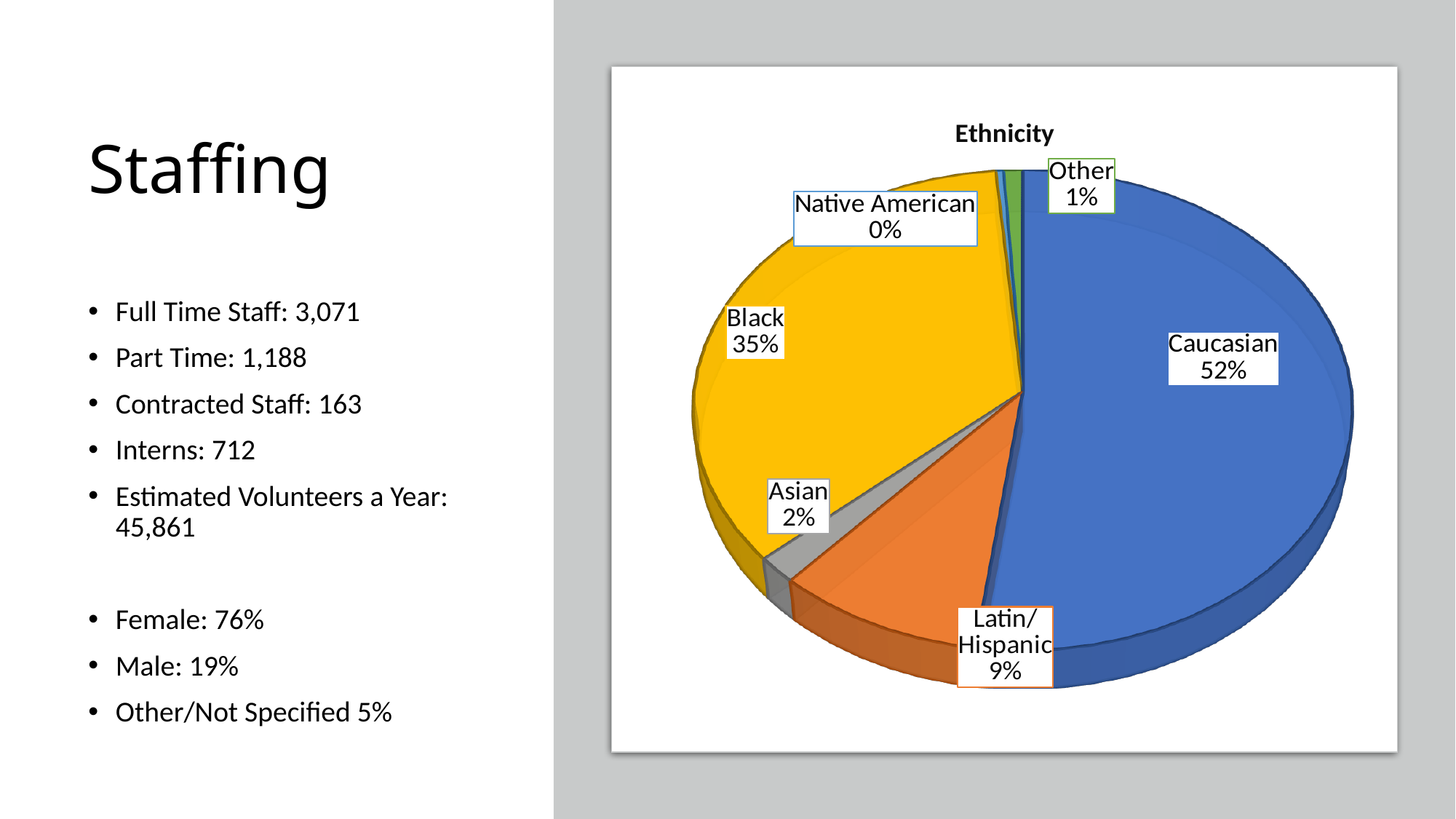
What is the value shown for Asian? 2% What is the difference between the Caucasian and Black shares? 17% What share of the pie is Black? 35% Which is larger, the Latin/Hispanic share or the Asian share? Latin/Hispanic What share of the pie is Caucasian? 52% What is the title of the chart? Ethnicity How many categories are shown in the pie chart? 6 What is the value shown for Latin/Hispanic? 9% What is the value shown for Native American? 0% Which category has the smallest slice of the pie? Native American What kind of chart is shown on the slide? pie chart Which category has the largest slice of the pie? Caucasian